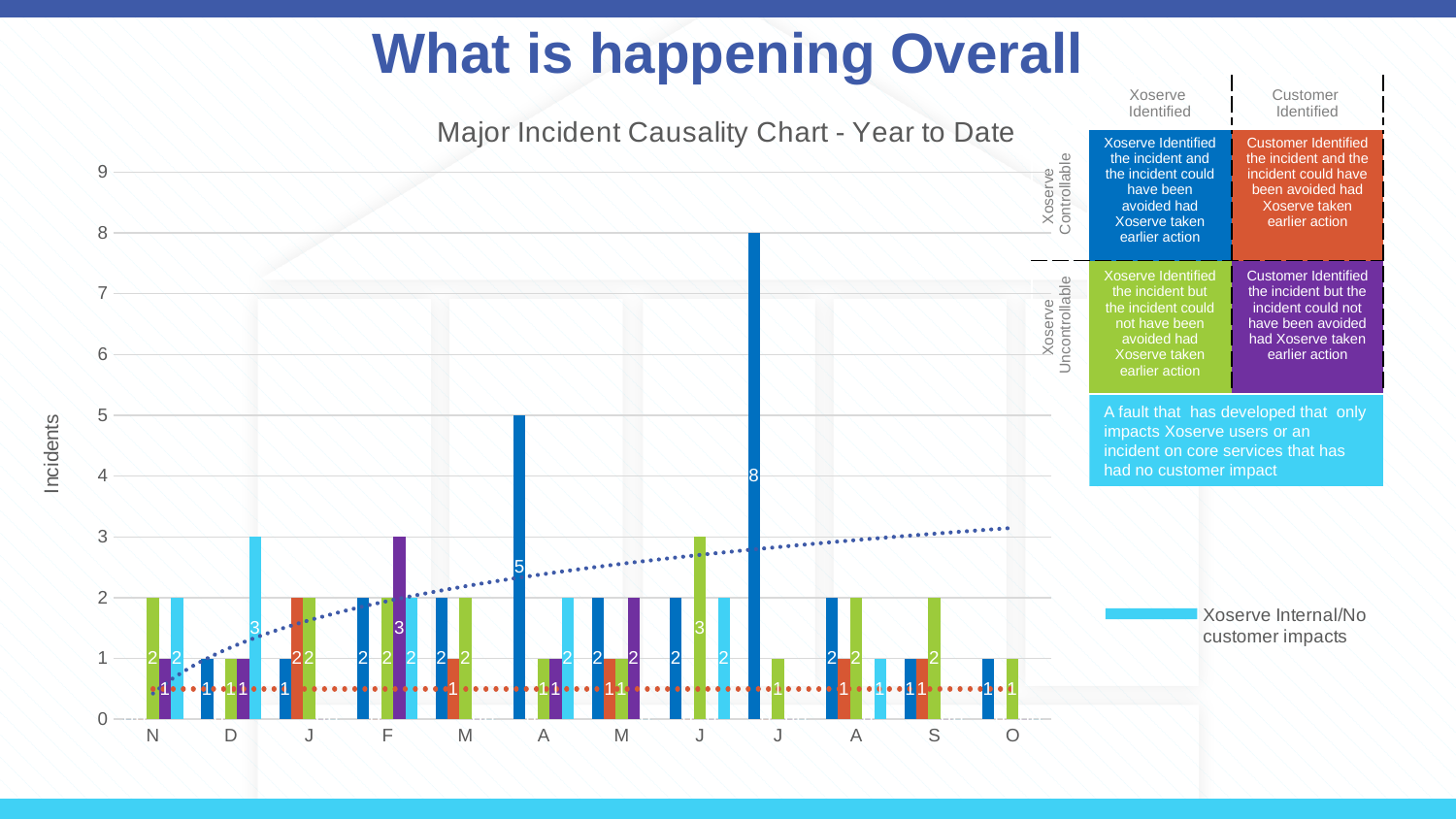
Which is larger: the tallest bar in the second 'J' month or the tallest bar in the first 'A' month? the first 'A' month What is the difference between the tallest bar (8) and the bar labeled 5? 3 What kind of chart is the Major Incident Causality Chart? bar chart Is the tallest bar in the first 'A' month greater or less than 4? greater How many months are shown along the x axis of the chart? 12 Is the tallest bar in the chart greater or less than 7? greater What is the label on the vertical axis of the chart? Incidents What is the highest tick value shown on the vertical axis? 9 What is the title of the chart on the slide? Major Incident Causality Chart - Year to Date What is the highest value reached by any bar in the chart? 8 What is the value labeled on the tallest bar in the first 'A' month? 5 Does the dotted trend line rise or fall from left to right across the chart? rise